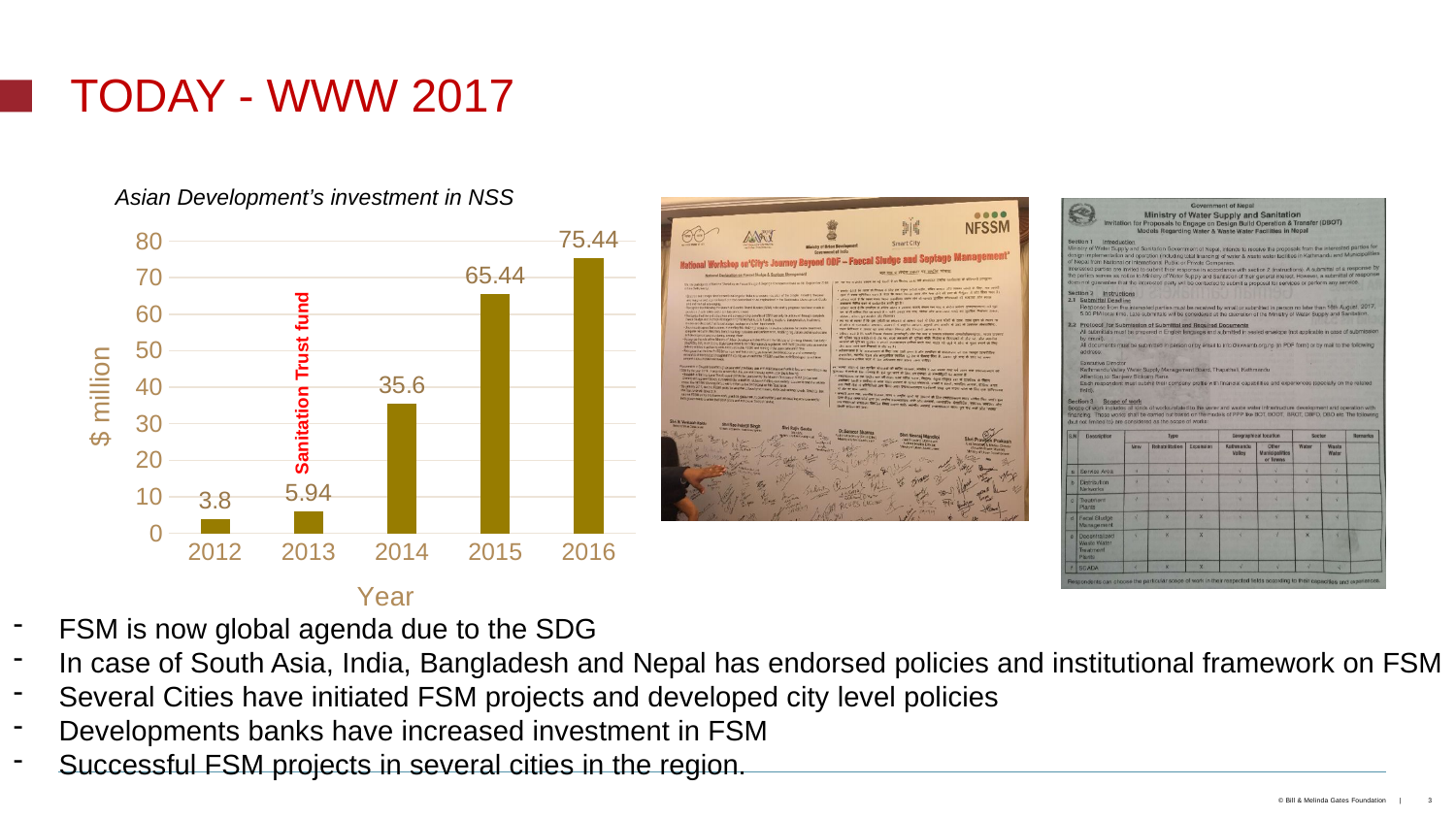
Do the values rise or fall from 2012 to 2016 in the chart 'Asian Development's investment in NSS'? rise What is the difference between the values for 2013 and 2012 in the chart 'Asian Development's investment in NSS'? 2.14 What is the value for 2014 in the chart 'Asian Development's investment in NSS'? 35.6 What is the value for 2012 in the chart 'Asian Development's investment in NSS'? 3.8 Which year has the lowest value in the chart 'Asian Development's investment in NSS'? 2012 What is the value for 2016 in the chart 'Asian Development's investment in NSS'? 75.44 What is the difference between the values for 2016 and 2015 in the chart 'Asian Development's investment in NSS'? 10 What kind of chart is 'Asian Development's investment in NSS'? bar chart Which is larger in the chart 'Asian Development's investment in NSS', the value for 2014 or the value for 2015? 2015 Is the value for 2015 greater or less than 60 in the chart 'Asian Development's investment in NSS'? greater How many years are shown on the x axis of the chart 'Asian Development's investment in NSS'? 5 Which year has the highest value in the chart 'Asian Development's investment in NSS'? 2016